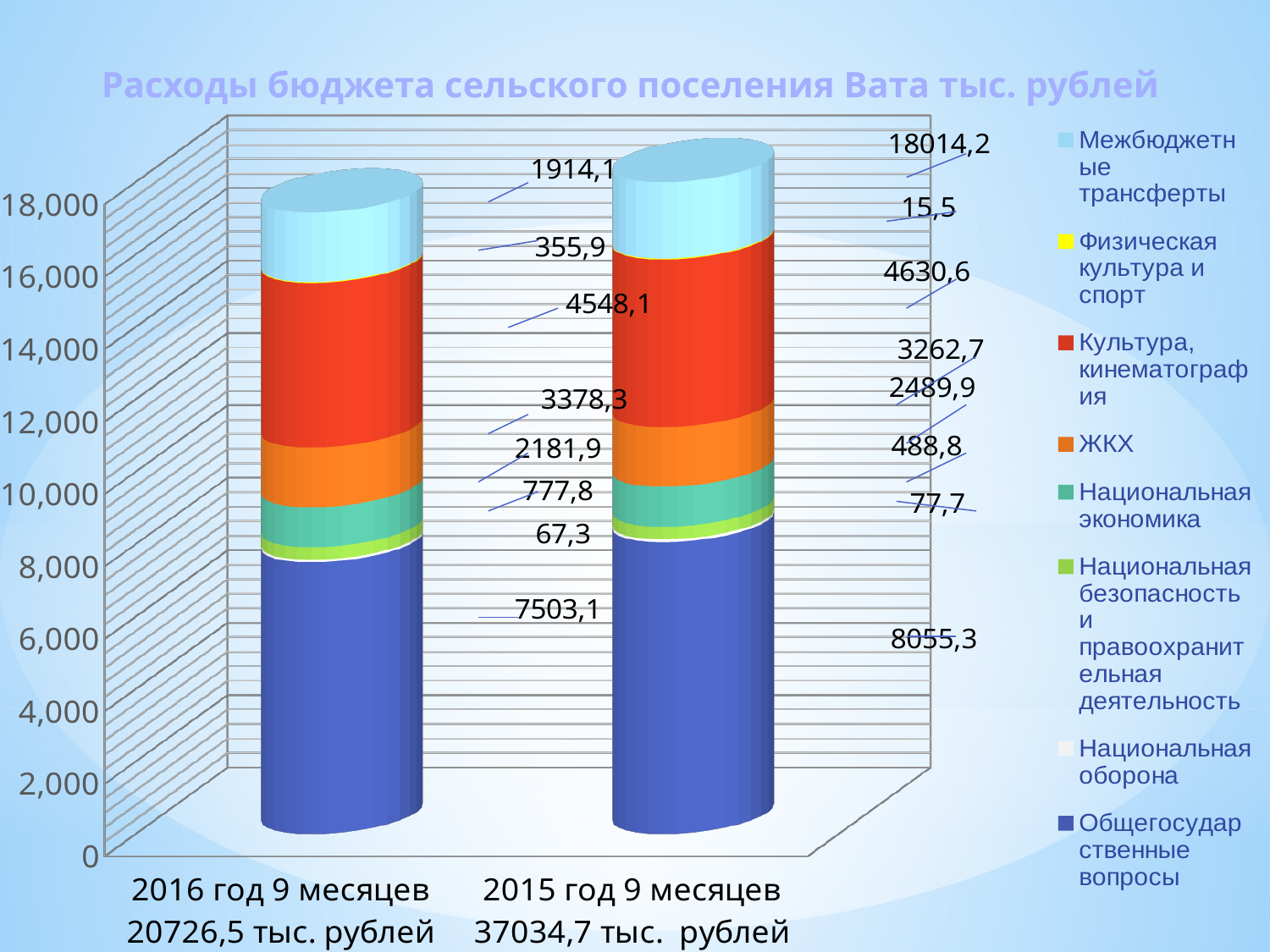
What is the value of ЖКХ for 2016 год 9 месяцев? 3378,3 What kind of chart is shown on the slide? Stacked bar chart Which is larger: Национальная экономика in 2016 год 9 месяцев or in 2015 год 9 месяцев? 2015 год 9 месяцев Which series has the smallest value in the 2016 год 9 месяцев bar? Национальная оборона What is the value of Общегосударственные вопросы for 2016 год 9 месяцев? 7503,1 How many bars (categories) are plotted on the chart? 2 What is the title of the chart? Расходы бюджета сельского поселения Вата тыс. рублей What is the total of the stacked bar for 2015 год 9 месяцев? 37034,7 тыс. рублей What is the value of Физическая культура и спорт for 2015 год 9 месяцев? 15,5 What is the difference between Культура, кинематография in 2015 (4630,6) and in 2016 (4548,1)? 82,5 How many series does the legend list? 8 What is the value of Межбюджетные трансферты for 2015 год 9 месяцев? 18014,2